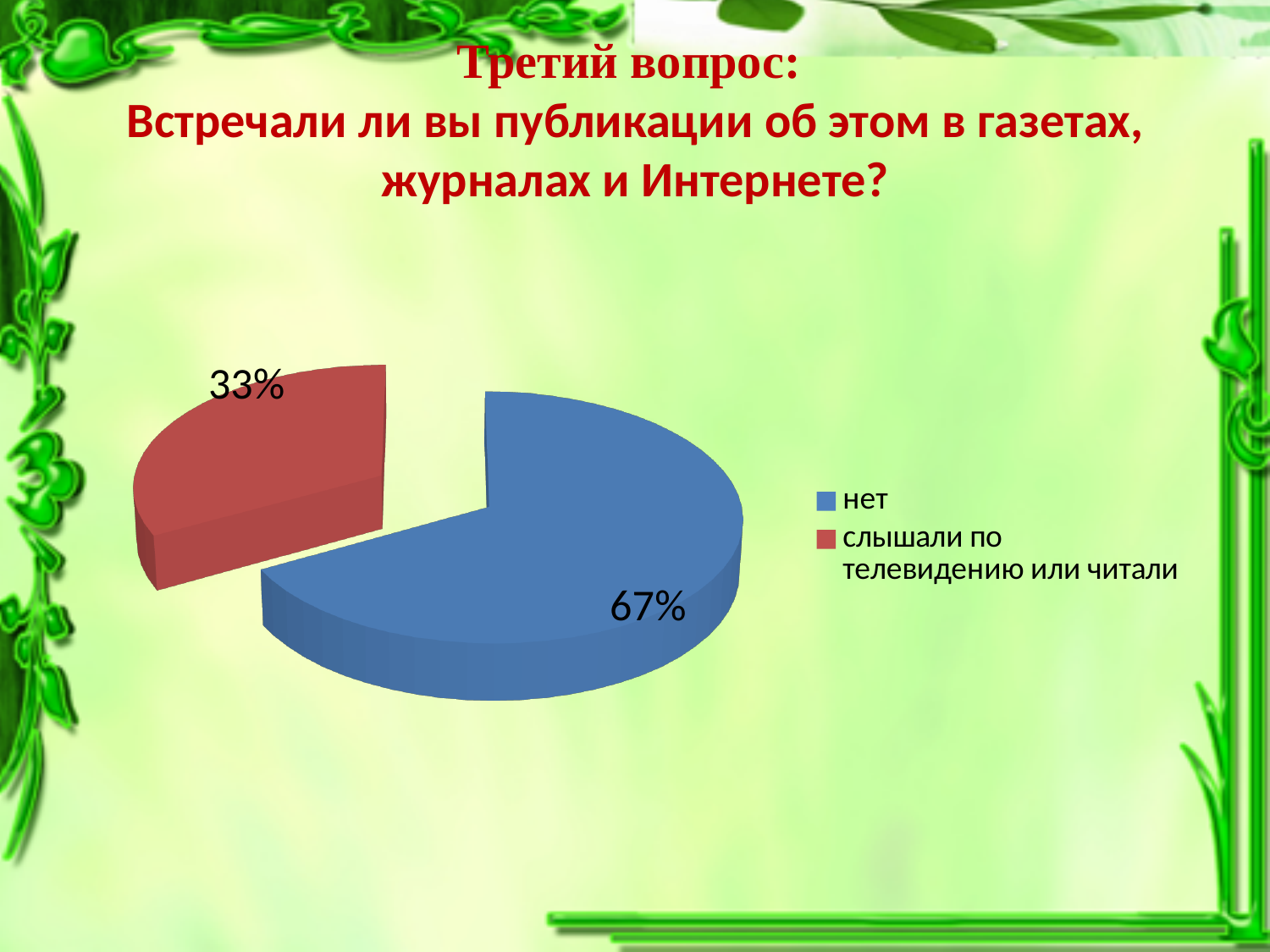
Which is larger: the "нет" slice or the "слышали по телевидению или читали" slice? нет What is the difference in percentage points between the "нет" slice and the "слышали по телевидению или читали" slice? 34 What share of the pie does the "нет" slice represent? 67% How many entries does the legend list? 2 What colour is the "слышали по телевидению или читали" slice? red Which category has the largest slice of the pie? нет Which category has the smallest slice of the pie? слышали по телевидению или читали What share of the pie does the "слышали по телевидению или читали" slice represent? 33% What kind of chart is shown on the slide? pie chart How many slices does the pie chart have? 2 What colour is the "нет" slice? blue